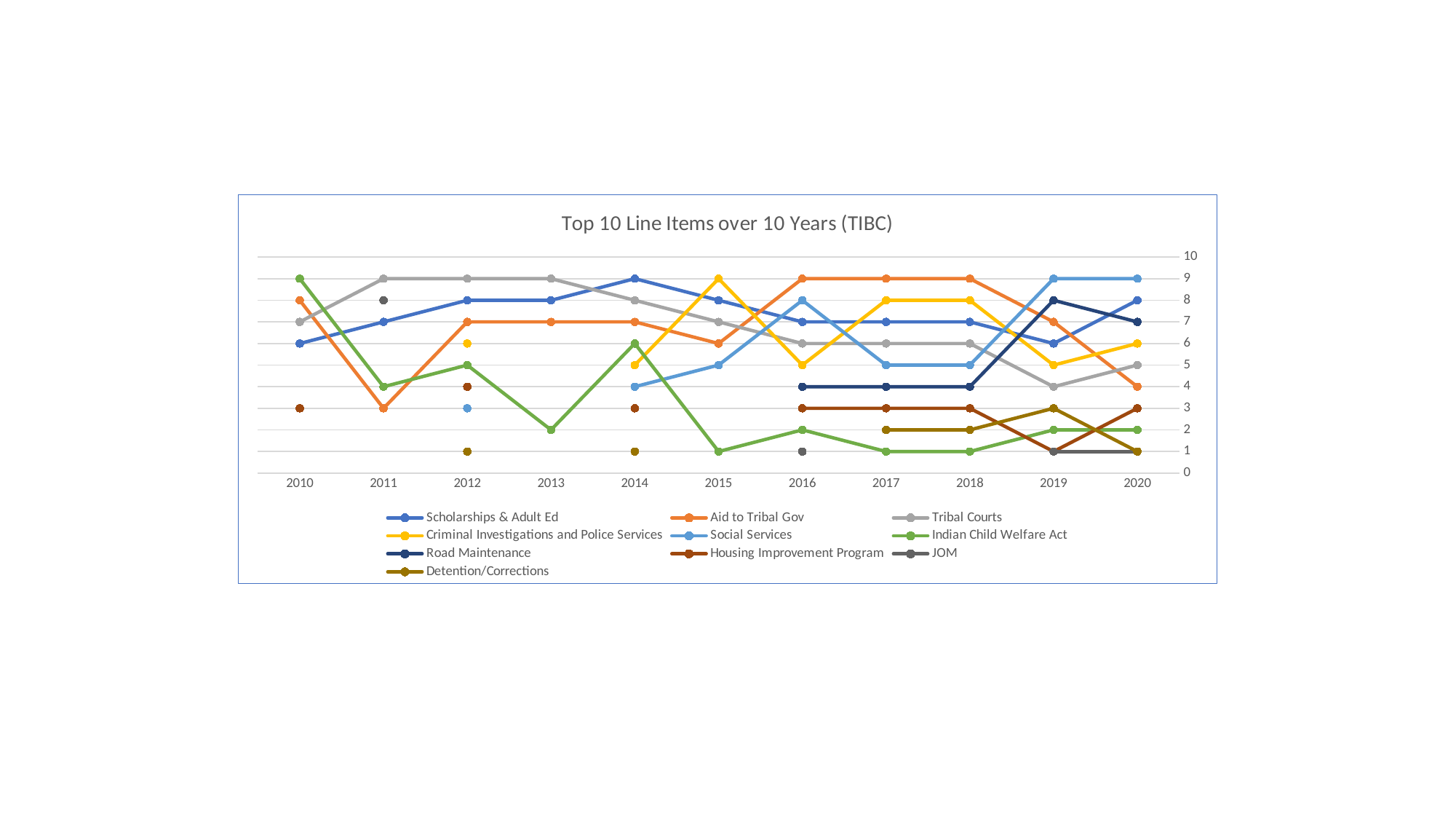
What is the value for Indian Child Welfare Act in 2010? 9 What is the title of the chart? Top 10 Line Items over 10 Years (TIBC) What is the value for Scholarships & Adult Ed in 2014? 9 How many years are shown on the x axis? 11 Does the Tribal Courts line rise or fall from 2013 to 2019? Fall What is the value for Aid to Tribal Gov in 2016? 9 What kind of chart is shown on the slide? Line chart What is the value for Social Services in 2020? 9 Which is larger in 2019, Road Maintenance or Tribal Courts? Road Maintenance How many series does the legend list? 10 Which series has the highest value in 2013? Tribal Courts What is the difference between Aid to Tribal Gov and Indian Child Welfare Act in 2018? 8